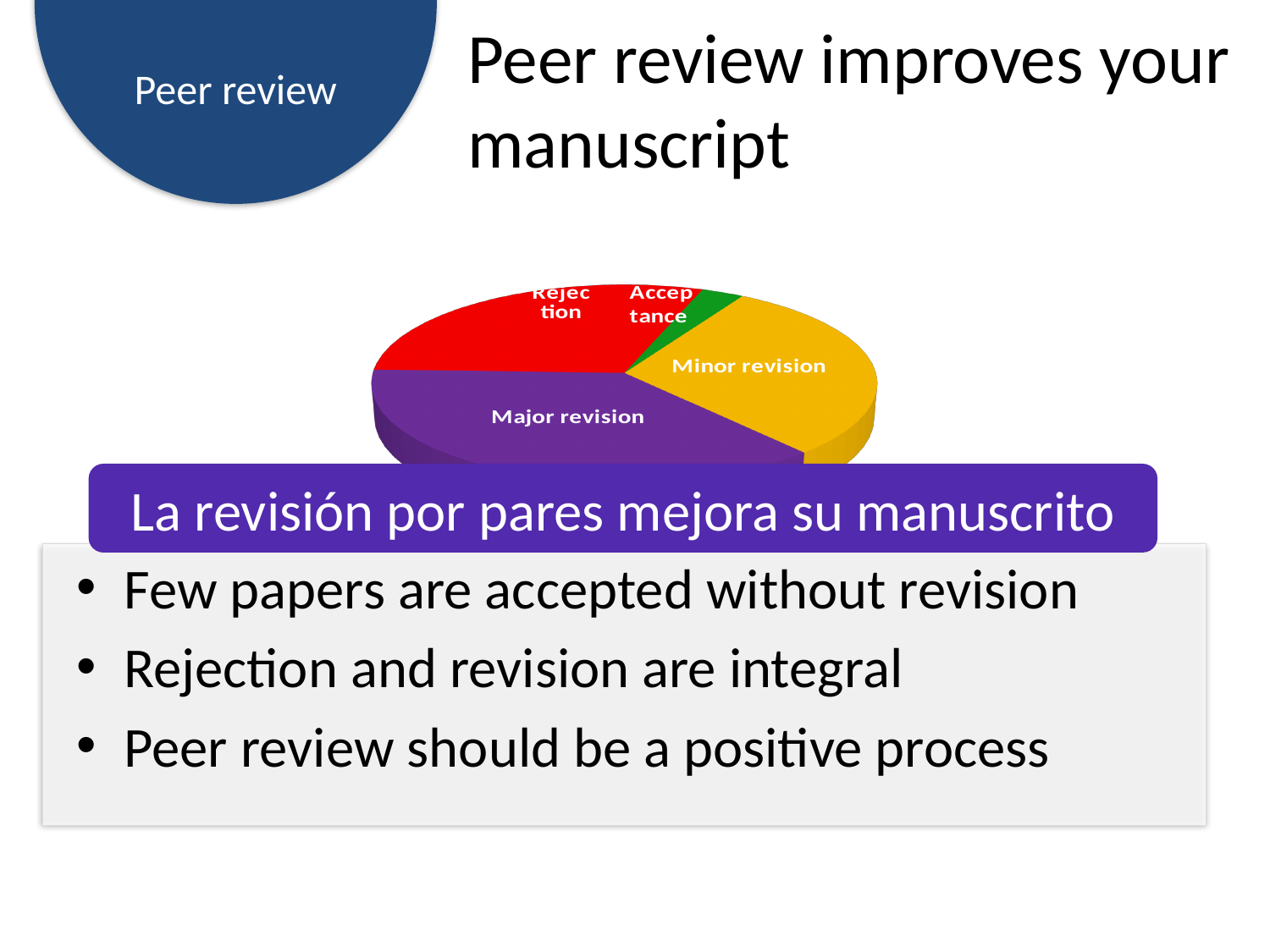
Which slice is larger in the pie chart, Acceptance or Major revision? Major revision Which slice of the pie chart is coloured green? Acceptance Which slice is larger in the pie chart, Acceptance or Minor revision? Minor revision What kind of chart is shown on the slide? pie chart What colour is the Major revision slice in the pie chart? purple Which slice is larger in the pie chart, Acceptance or Rejection? Rejection Which slice of the pie chart is the smallest? Acceptance How many slices does the pie chart have? 4